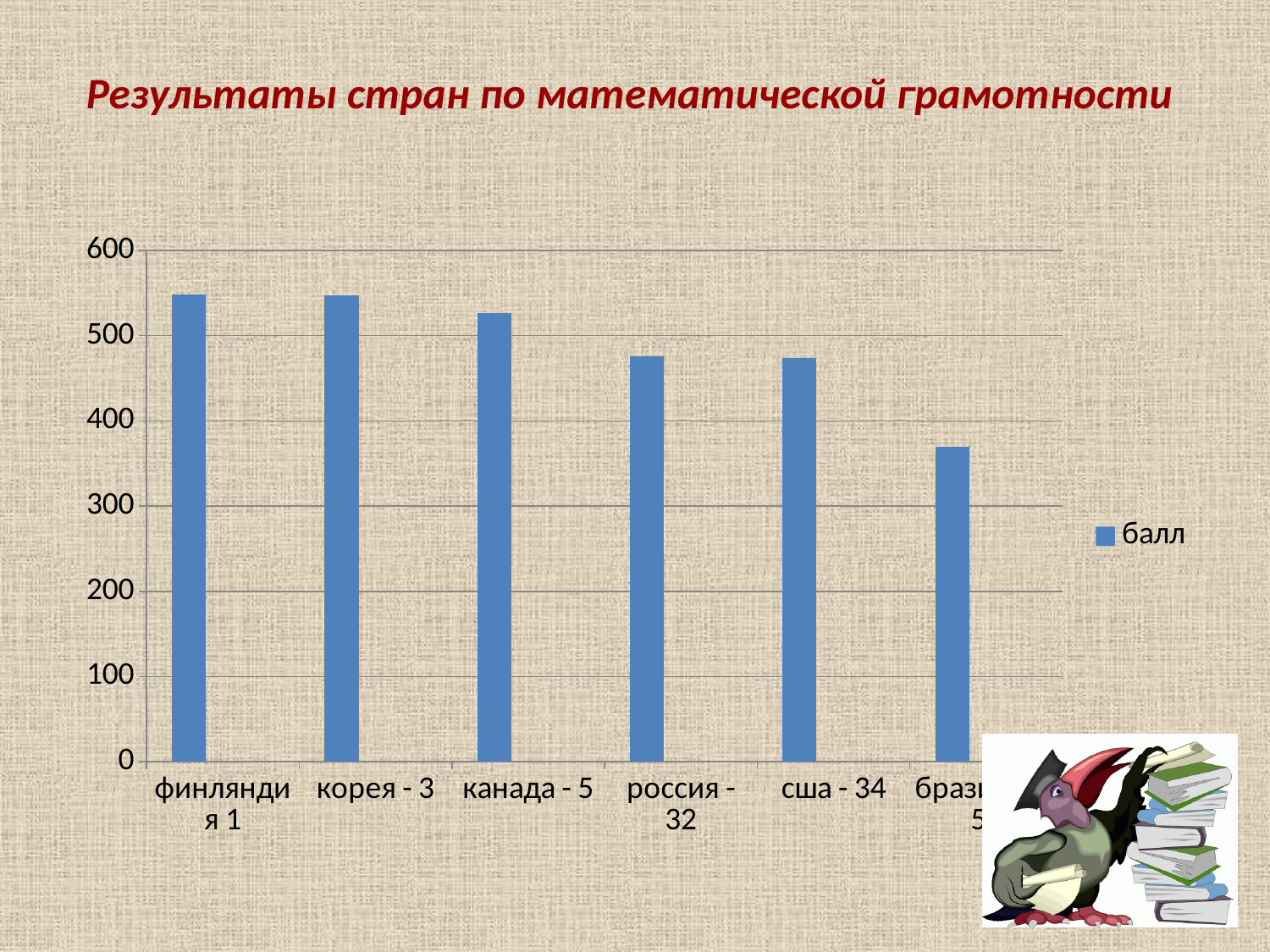
Which has the larger value, финляндия 1 or канада - 5? финляндия 1 Which has the larger value, канада - 5 or россия - 32? канада - 5 What is the title of the chart? Результаты стран по математической грамотности How many series does the legend list? 1 Do the values generally rise or fall from left to right along the x axis? fall Is the value for россия - 32 greater or less than 500? less Is the value for финляндия 1 greater or less than 500? greater How many bars are plotted in the chart? 6 Is the value for сша - 34 greater or less than 400? greater What is the legend entry for the series? балл What kind of chart is shown on the slide? bar chart